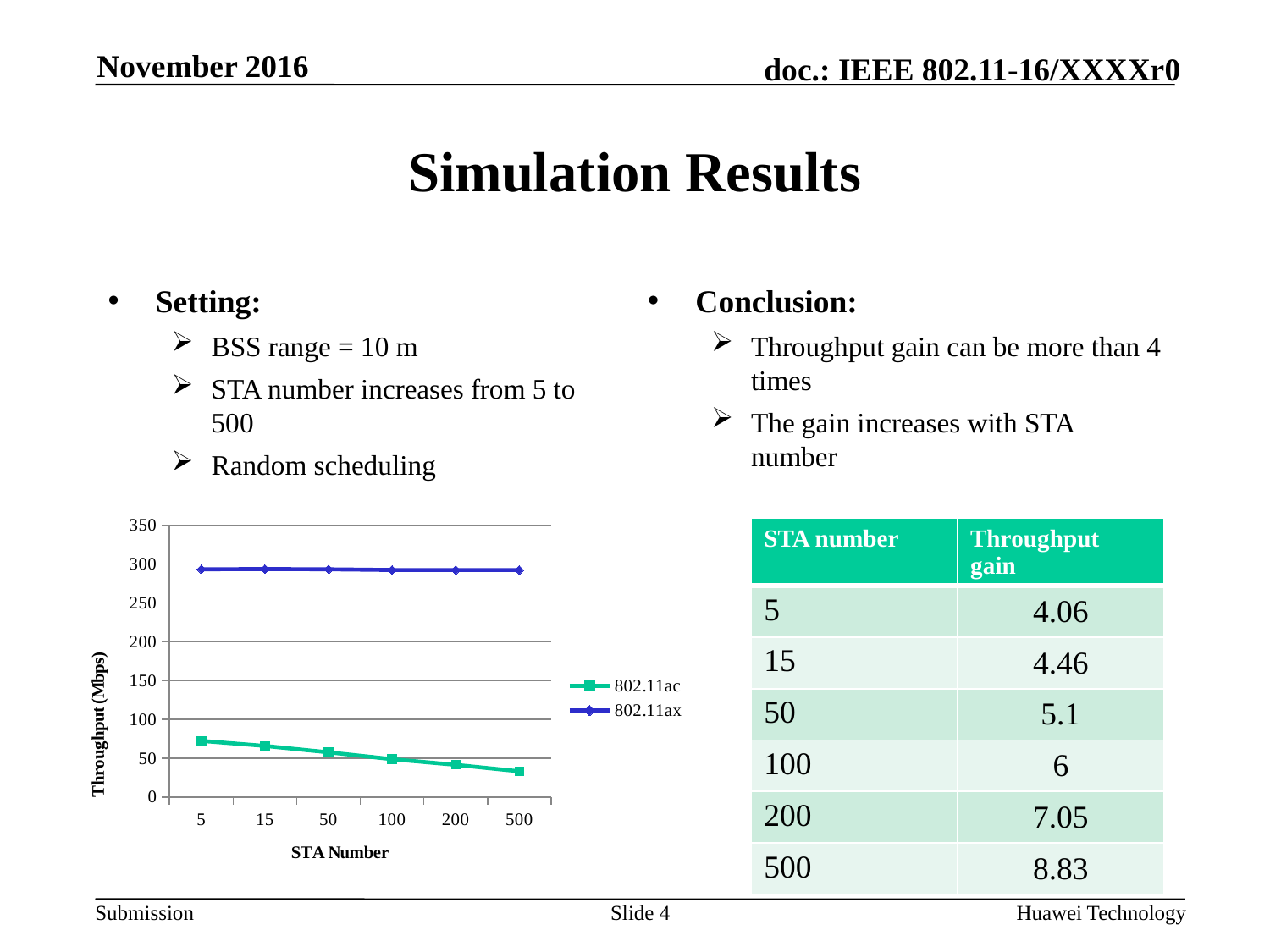
How many series does the chart's legend list? 2 How many STA Number values are plotted along the x axis of the chart? 6 Is the throughput of 802.11ac at STA Number 500 greater or less than 50? less Which series has the higher throughput at STA Number 500, 802.11ac or 802.11ax? 802.11ax Is the throughput of 802.11ac at STA Number 5 greater or less than 50? greater What is the label of the chart's y axis? Throughput (Mbps) What is the label of the chart's x axis? STA Number What kind of chart is shown on the slide? line chart Does the throughput of 802.11ac rise or fall as STA Number increases from 5 to 500? fall Is the throughput of 802.11ax at STA Number 5 greater or less than 250? greater Which series has the lower throughput at STA Number 5, 802.11ac or 802.11ax? 802.11ac